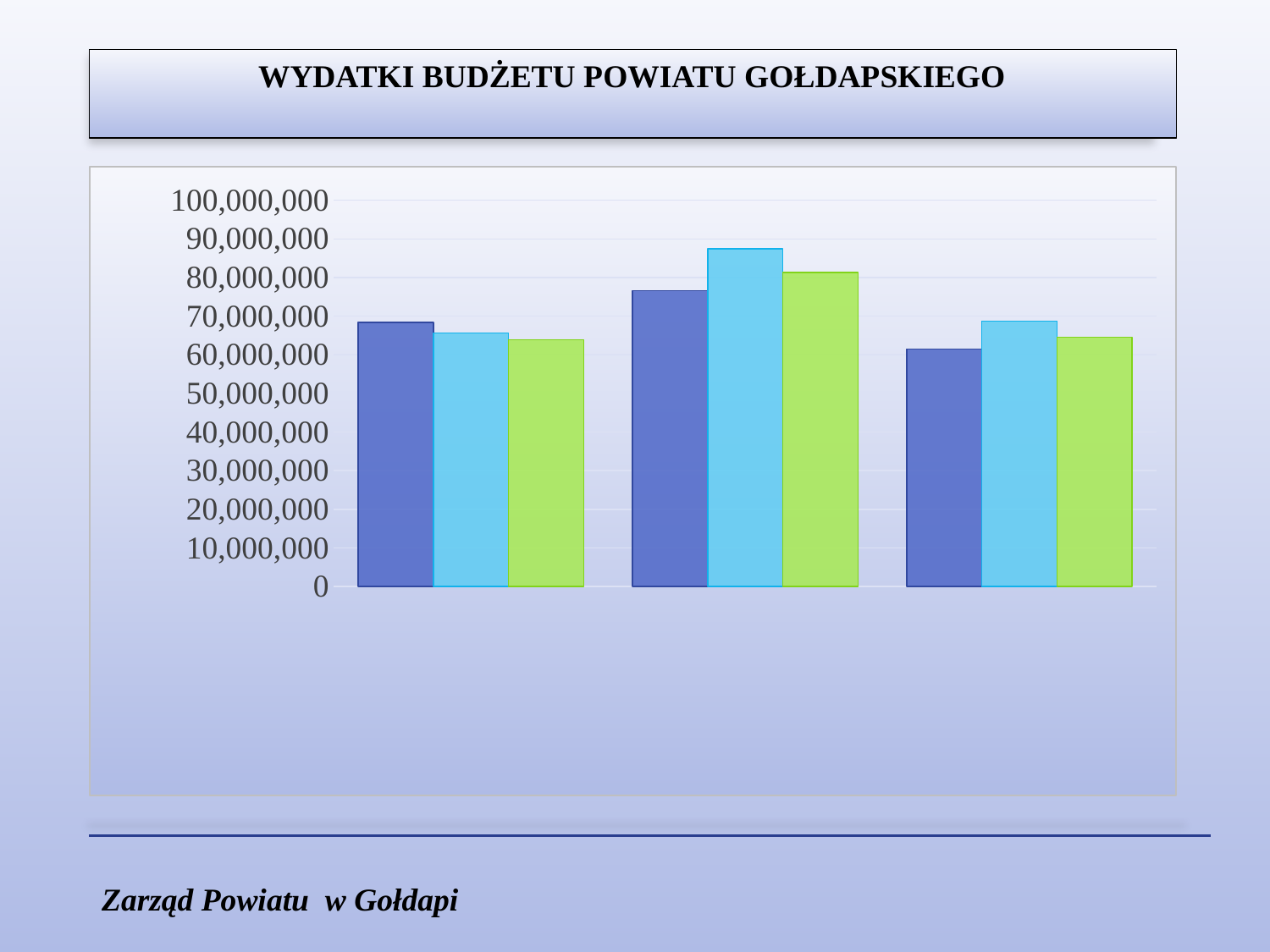
What is the title shown above the chart? WYDATKI BUDŻETU POWIATU GOŁDAPSKIEGO What kind of chart is shown on the slide? bar chart Is the value of the green bar in the middle group greater or less than 70,000,000? greater How many bars are there in each group on the chart? 3 Is the value of the light blue bar in the middle group greater or less than 80,000,000? greater In the right group, which is larger: the light blue bar or the dark blue bar? light blue bar What is the highest value shown on the vertical axis? 100,000,000 Which colour bar is the tallest in the middle group? light blue Is the value of the dark blue bar in the right group greater or less than 70,000,000? less How many groups of bars are plotted on the chart? 3 Which group of bars (left, middle or right) contains the tallest bar on the chart? middle In the left group, which is larger: the dark blue bar or the green bar? dark blue bar